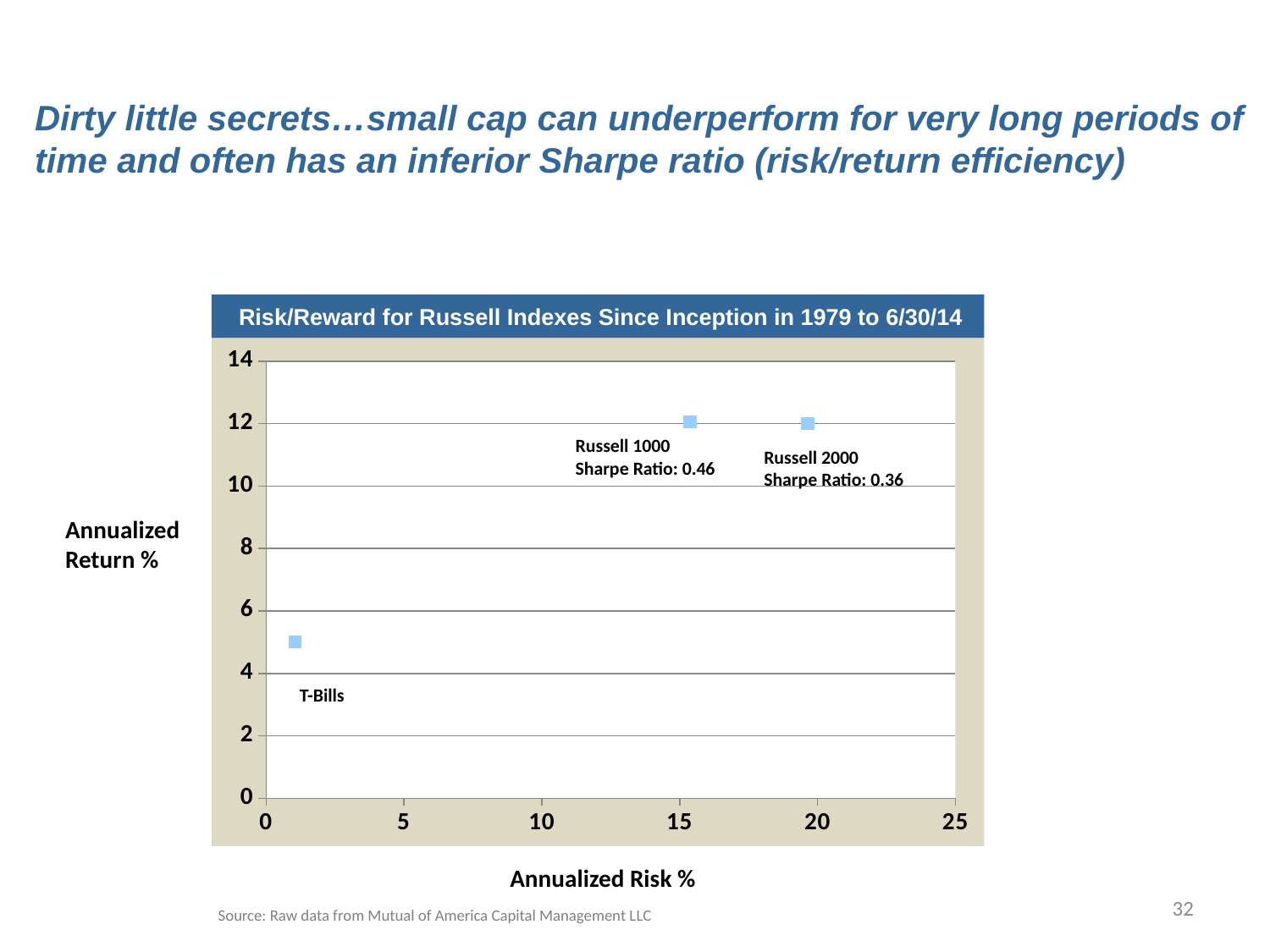
What Sharpe ratio is shown for Russell 1000? 0.46 What Sharpe ratio is shown for Russell 2000? 0.36 Is the annualized risk for Russell 2000 greater or less than 15? greater What kind of chart is shown on the slide? scatter chart What is the difference between the Sharpe ratios of Russell 1000 and Russell 2000? 0.10 What is the title of the chart? Risk/Reward for Russell Indexes Since Inception in 1979 to 6/30/14 Is the annualized return for T-Bills greater or less than 6? less Which has the higher Sharpe ratio, Russell 1000 or Russell 2000? Russell 1000 How many data points are plotted on the chart? 3 Which plotted point has the highest annualized risk? Russell 2000 What is the label of the horizontal axis? Annualized Risk % Which plotted point has the lowest annualized return? T-Bills